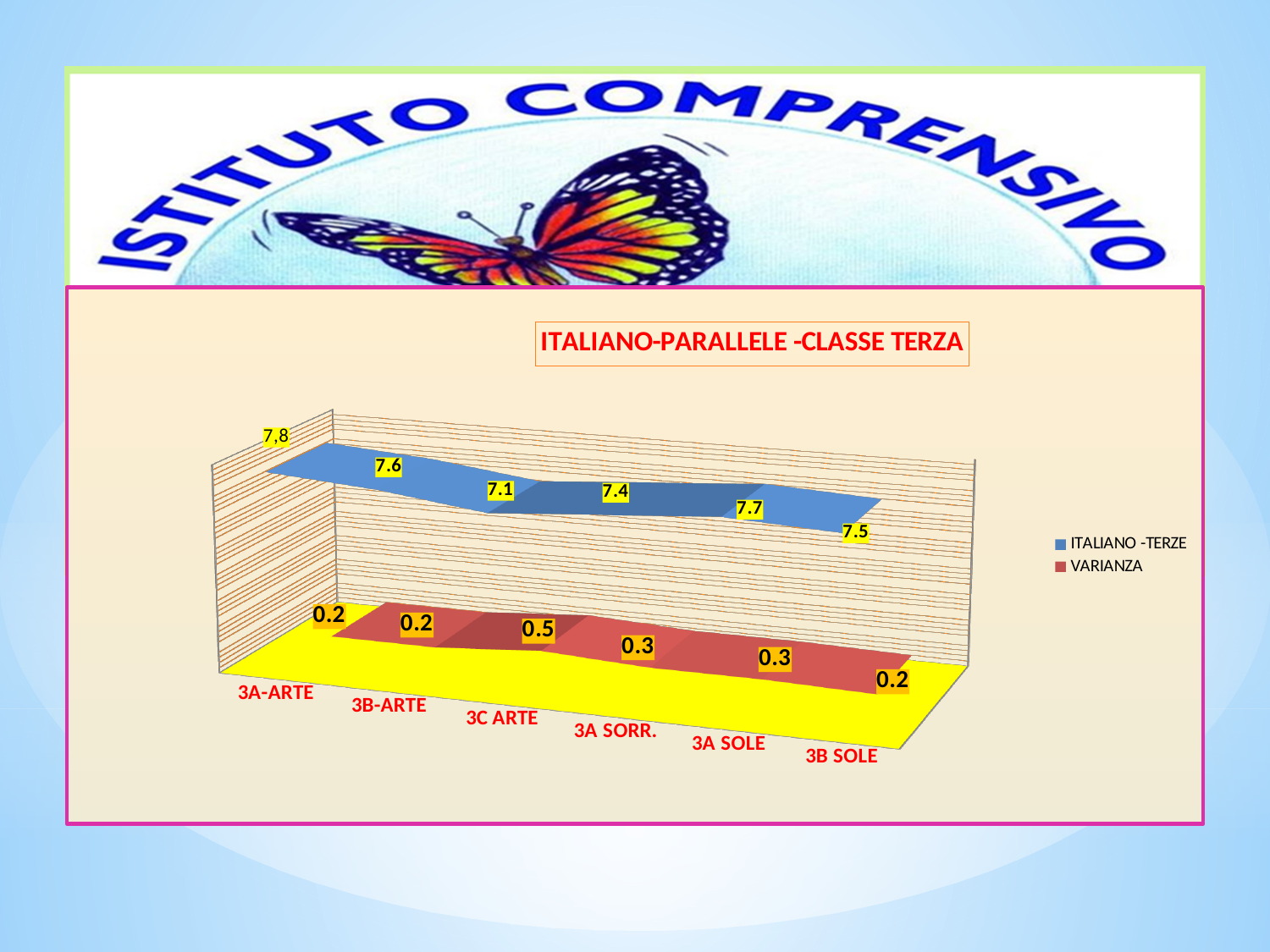
Which category has the highest VARIANZA value? 3C ARTE What is the title of the chart? ITALIANO-PARALLELE -CLASSE TERZA Which category has the highest ITALIANO -TERZE value? 3A-ARTE What is the difference between the ITALIANO -TERZE values for 3A SOLE and 3A SORR.? 0.3 What is the VARIANZA value for 3C ARTE? 0.5 What is the VARIANZA value for 3B SOLE? 0.2 How many series does the legend list? 2 Which category has the lowest ITALIANO -TERZE value? 3C ARTE How many categories are shown on the x axis? 6 What is the ITALIANO -TERZE value for 3A SOLE? 7.7 Which is larger, the ITALIANO -TERZE value for 3B-ARTE or for 3B SOLE? 3B-ARTE What is the ITALIANO -TERZE value for 3C ARTE? 7.1